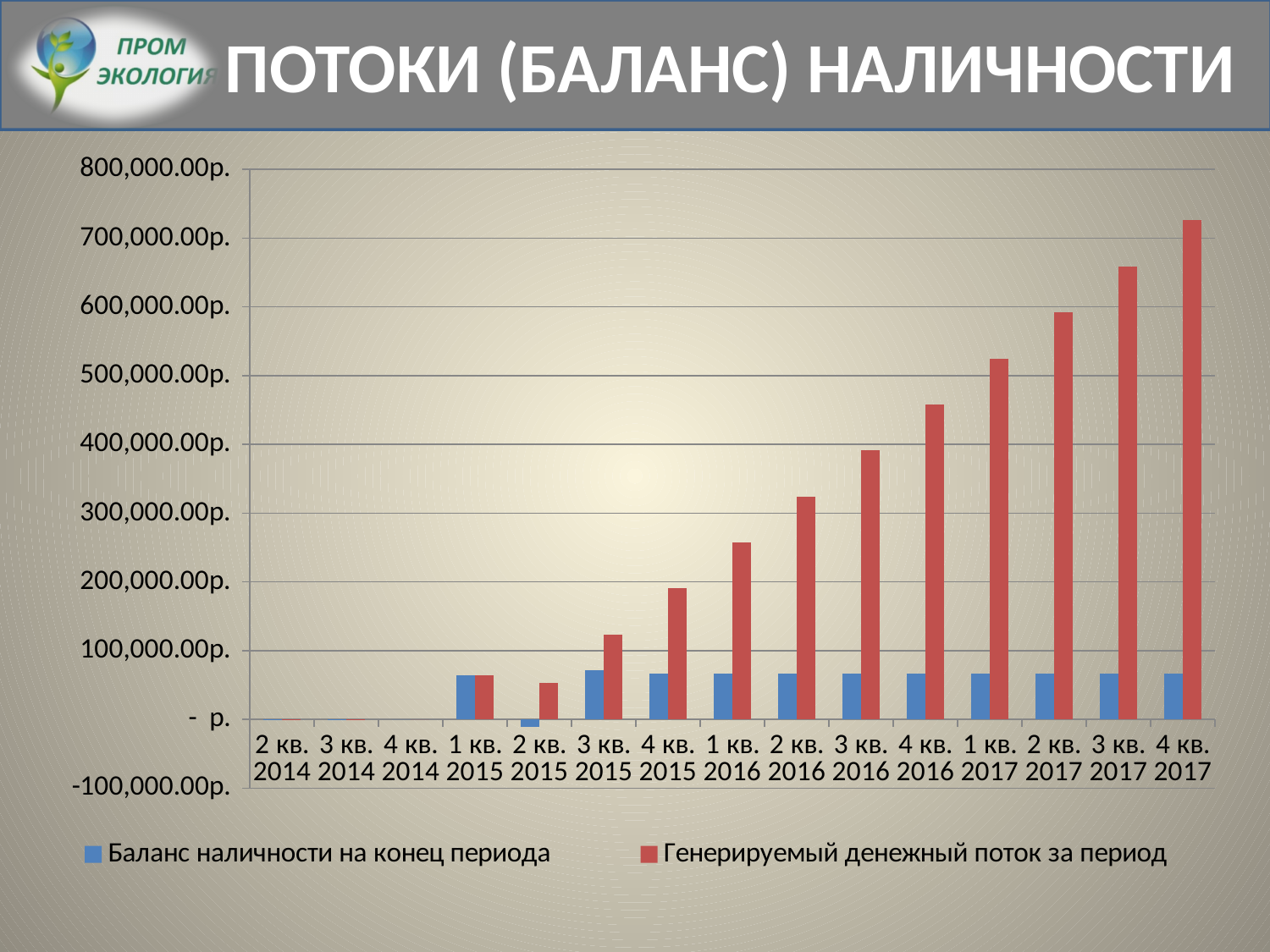
Which quarter has the lowest value for Баланс наличности на конец периода? 2 кв. 2015 Which quarter has the highest value for Генерируемый денежный поток за период? 4 кв. 2017 Is the value for Генерируемый денежный поток за период in 4 кв. 2016 greater or less than 400,000.00р.? greater Is the value for Генерируемый денежный поток за период in 2 кв. 2015 greater or less than 100,000.00р.? less Is the value for Баланс наличности на конец периода in 4 кв. 2017 greater or less than 100,000.00р.? less Do the values for Генерируемый денежный поток за период rise or fall from 1 кв. 2016 to 4 кв. 2017? rise How many quarters (categories) are shown on the x axis? 15 What is the title of the slide containing the chart? ПОТОКИ (БАЛАНС) НАЛИЧНОСТИ What kind of chart is shown on the slide? bar chart In 4 кв. 2017, which series has the larger value: Баланс наличности на конец периода or Генерируемый денежный поток за период? Генерируемый денежный поток за период How many series does the legend list? 2